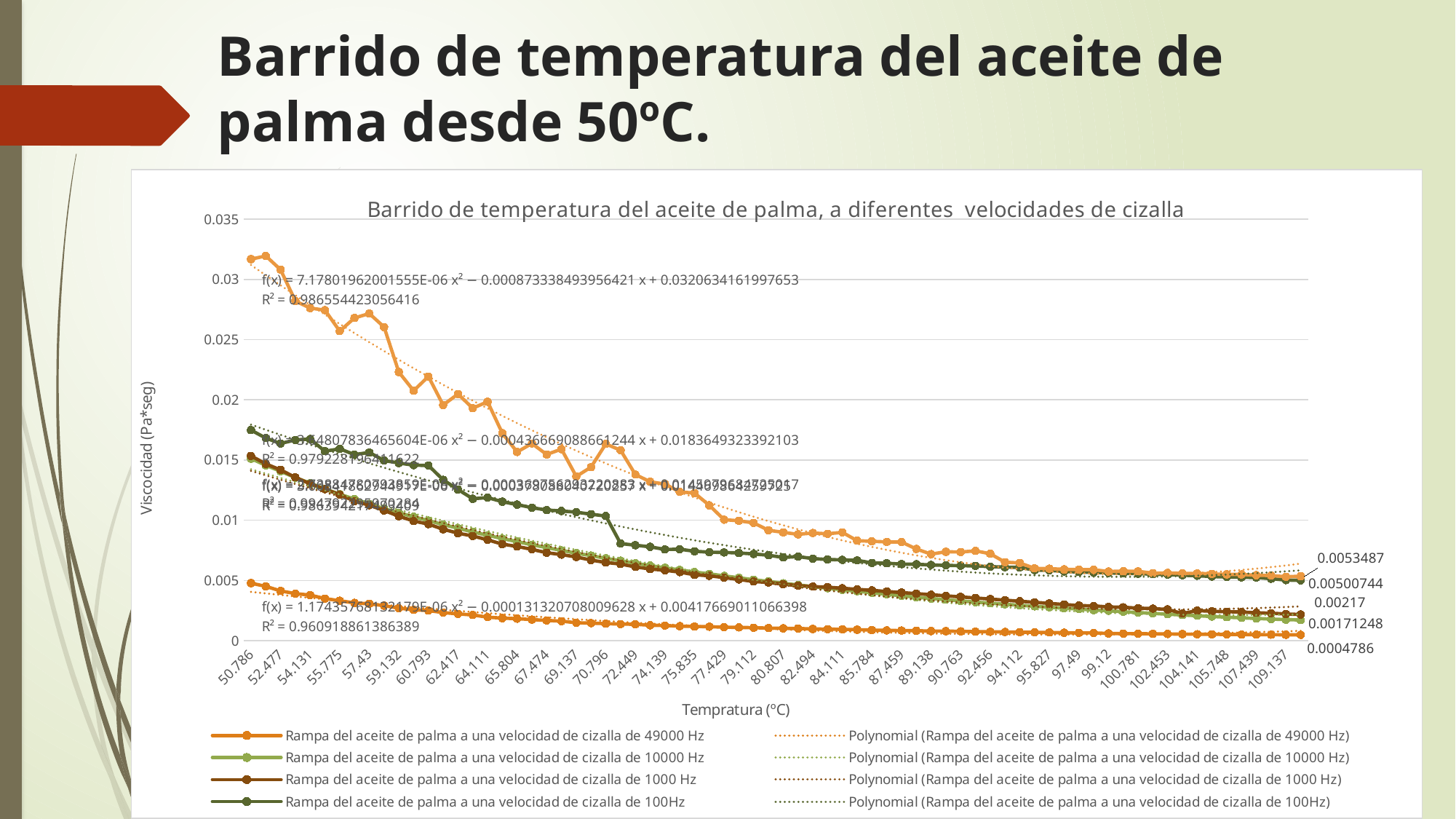
Do the viscosity values rise or fall as temperature increases along the x axis? Fall Is the value of the lowest series at 50.786 °C greater or less than 0.01? less How many entries does the chart legend list? 8 Is the value of the topmost series at 50.786 °C greater or less than 0.03? greater What is the highest data label shown at the right end of the chart? 0.0053487 What is the label of the vertical axis of the chart? Viscocidad (Pa*seg) What kind of chart is shown on the slide? Line chart What is the R² value printed for the topmost trendline equation (the one starting with f(x) = 7.17801962001555E-06 x²)? 0.986554423056416 What is the difference between the end data labels 0.0053487 and 0.00500744? 0.00034126 What is the title of the chart? Barrido de temperatura del aceite de palma, a diferentes velocidades de cizalla What is the lowest data label shown at the right end of the chart? 0.0004786 What is the R² value printed for the lowest trendline equation (the one starting with f(x) = 1.17435768132179E-06 x²)? 0.960918861386389